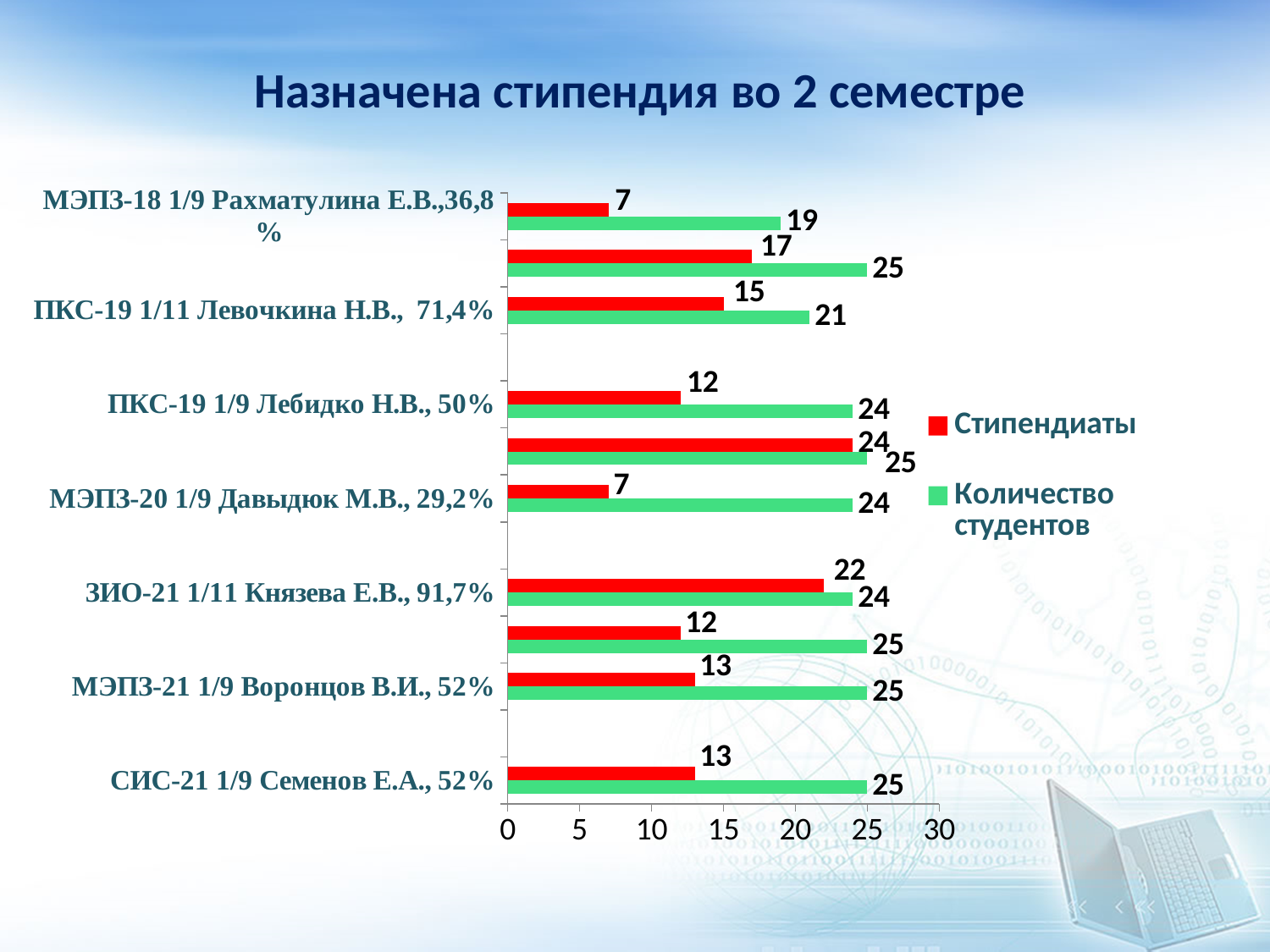
Among the labelled categories, which has the highest Стипендиаты value? ЗИО-21 1/11 Князева Е.В., 91,7% What is the value of Количество студентов for ПКС-19 1/11 Левочкина Н.В., 71,4%? 21 What is the value of Количество студентов for МЭПЗ-18 1/9 Рахматулина Е.В., 36,8%? 19 What is the value of Стипендиаты for МЭПЗ-20 1/9 Давыдюк М.В., 29,2%? 7 What is the difference between Количество студентов and Стипендиаты for ПКС-19 1/9 Лебидко Н.В., 50%? 12 What is the difference between Количество студентов and Стипендиаты for СИС-21 1/9 Семенов Е.А., 52%? 12 What is the title of the chart? Назначена стипендия во 2 семестре What is the value of Стипендиаты for ЗИО-21 1/11 Князева Е.В., 91,7%? 22 Which is larger: Стипендиаты for ЗИО-21 1/11 Князева Е.В., 91,7% or Стипендиаты for МЭПЗ-21 1/9 Воронцов В.И., 52%? ЗИО-21 1/11 Князева Е.В., 91,7% How many series does the legend list? 2 What are the two series named in the legend? Стипендиаты; Количество студентов What type of chart is shown on the slide? bar chart